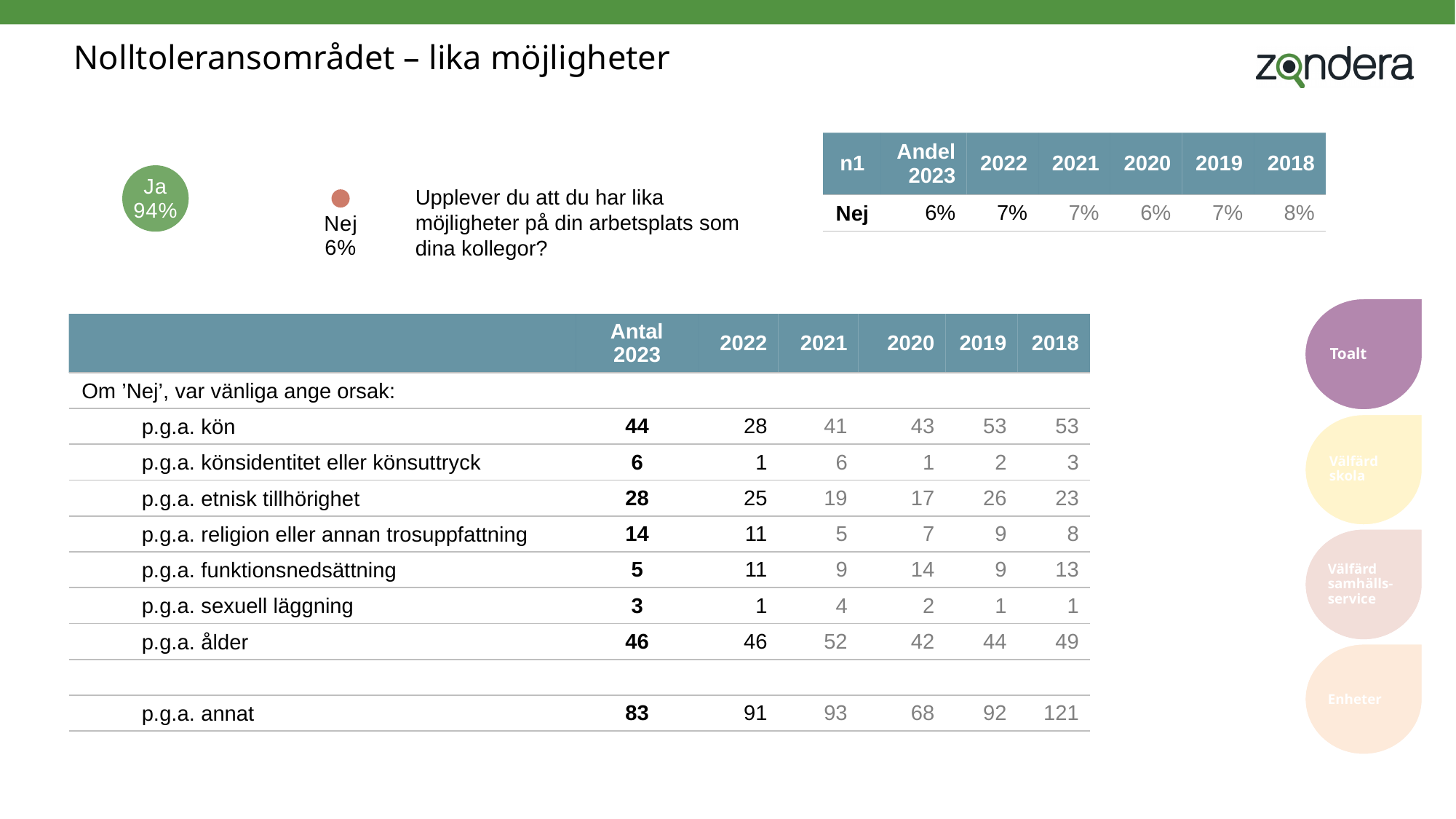
In the Ja/Nej chart, which answer has the highest share? Ja In the Ja/Nej chart, what is the difference in percentage points between the Ja share and the Nej share? 88 percentage points In the Ja/Nej chart, what colour is the circle representing "Ja"? Green In the Ja/Nej chart, which answer has the larger share, Ja or Nej? Ja In the Ja/Nej chart, what share of respondents answered "Nej"? 6% How many answer categories does the Ja/Nej chart show? 2 Which survey question does the Ja/Nej chart illustrate? Upplever du att du har lika möjligheter på din arbetsplats som dina kollegor? In the Ja/Nej chart, what share of respondents answered "Ja"? 94% In the Ja/Nej chart, which answer has the lowest share? Nej In the Ja/Nej chart, what do the Ja and Nej shares add up to? 100%